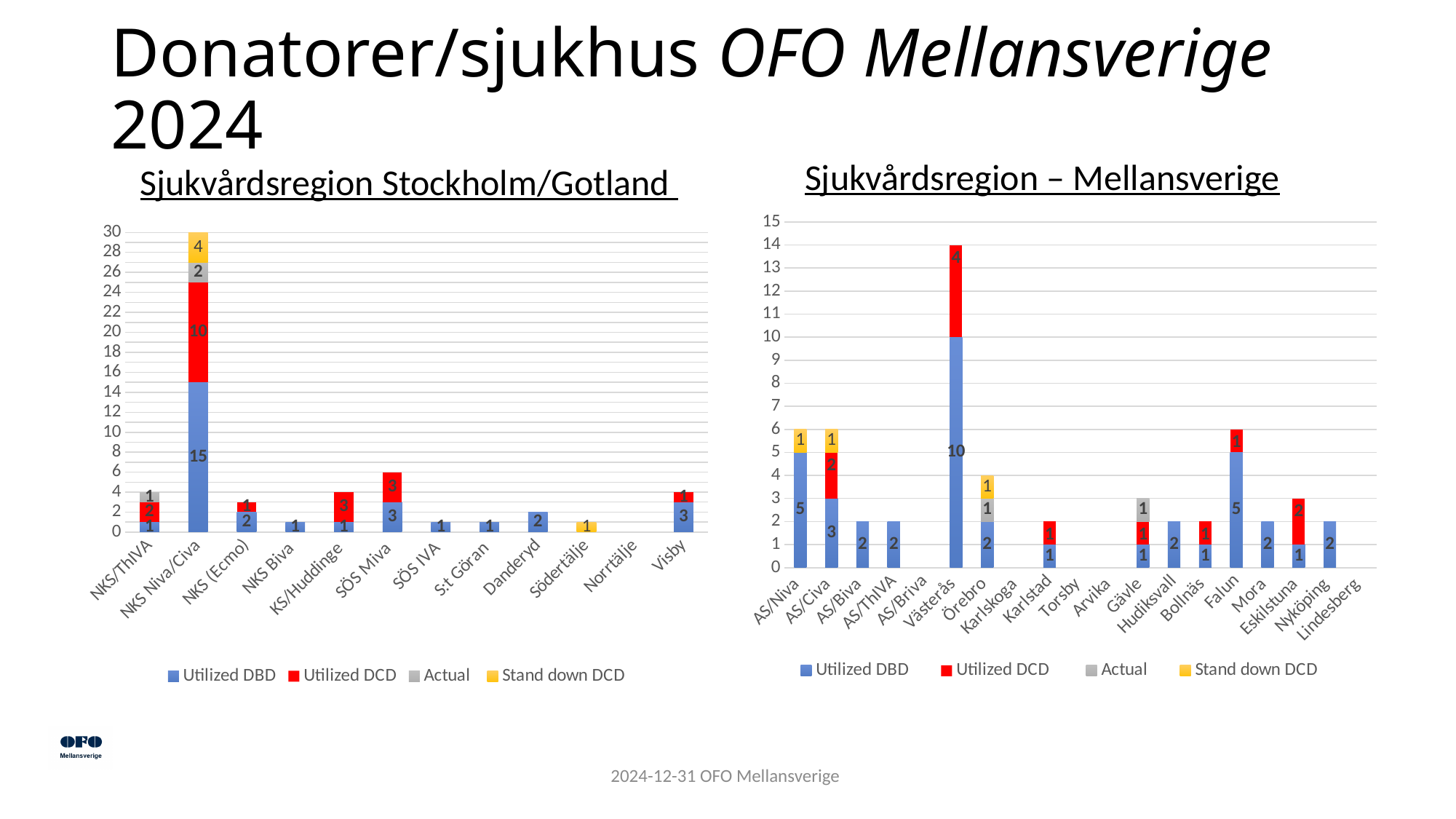
What type of chart is the Sjukvårdsregion Stockholm/Gotland chart? Stacked bar chart In the Sjukvårdsregion – Mellansverige chart, what is the Utilized DCD value for Eskilstuna? 2 In the Sjukvårdsregion – Mellansverige chart, what is the Utilized DBD value for Västerås? 10 In the Sjukvårdsregion Stockholm/Gotland chart, what is the Utilized DBD value for NKS Niva/Civa? 15 In the Sjukvårdsregion Stockholm/Gotland chart, what is the total of the stacked bar for SÖS Miva? 6 In the Sjukvårdsregion Stockholm/Gotland chart, how many hospital categories are shown on the x axis? 12 In the Sjukvårdsregion – Mellansverige chart, which is larger, the Utilized DBD value for Falun or for Gävle? Falun In the Sjukvårdsregion Stockholm/Gotland chart, which hospital has the highest stacked bar? NKS Niva/Civa In the Sjukvårdsregion Stockholm/Gotland chart, what is the Utilized DCD value for KS/Huddinge? 3 How many series does the legend of the Sjukvårdsregion – Mellansverige chart list? 4 In the Sjukvårdsregion – Mellansverige chart, what is the total of the stacked bar for Västerås? 14 In the Sjukvårdsregion – Mellansverige chart, what is the difference between the Utilized DBD values for AS/Niva and AS/Civa? 2